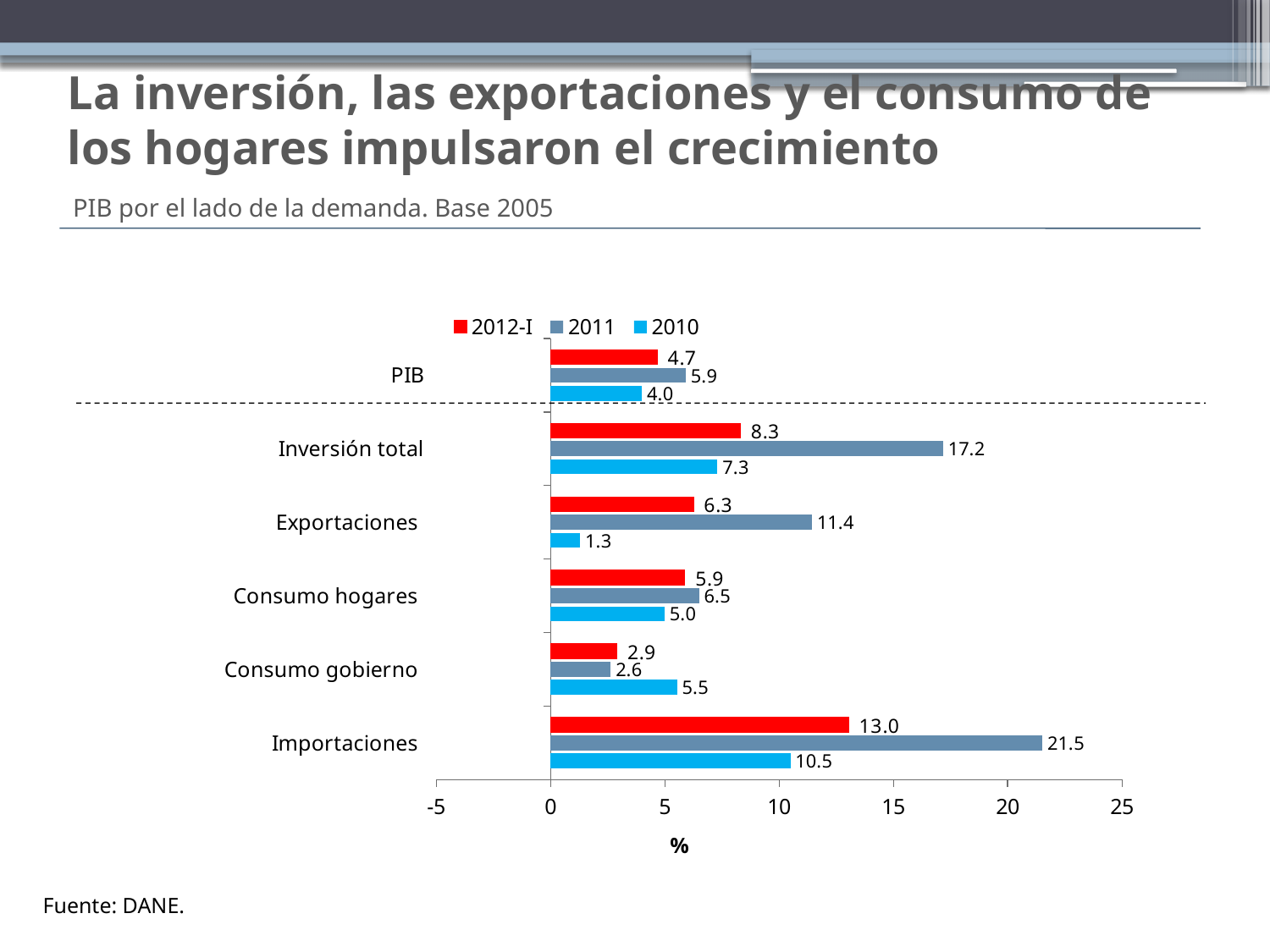
What is the value for Inversión total in the 2011 series? 17.2 What is the label on the horizontal axis of the chart? % What is the value for Exportaciones in the 2010 series? 1.3 What is the difference between the 2011 and 2010 values for Inversión total? 9.9 How many series does the legend list? 3 Which is larger for Consumo gobierno: the 2010 value or the 2012-I value? 2010 What is the difference between the 2011 and 2012-I values for Importaciones? 8.5 What is the value for PIB in the 2012-I series? 4.7 Which category has the lowest value in the 2010 series? Exportaciones How many categories are shown on the chart? 6 Which category has the highest value in the 2011 series? Importaciones What kind of chart is shown on the slide? Bar chart